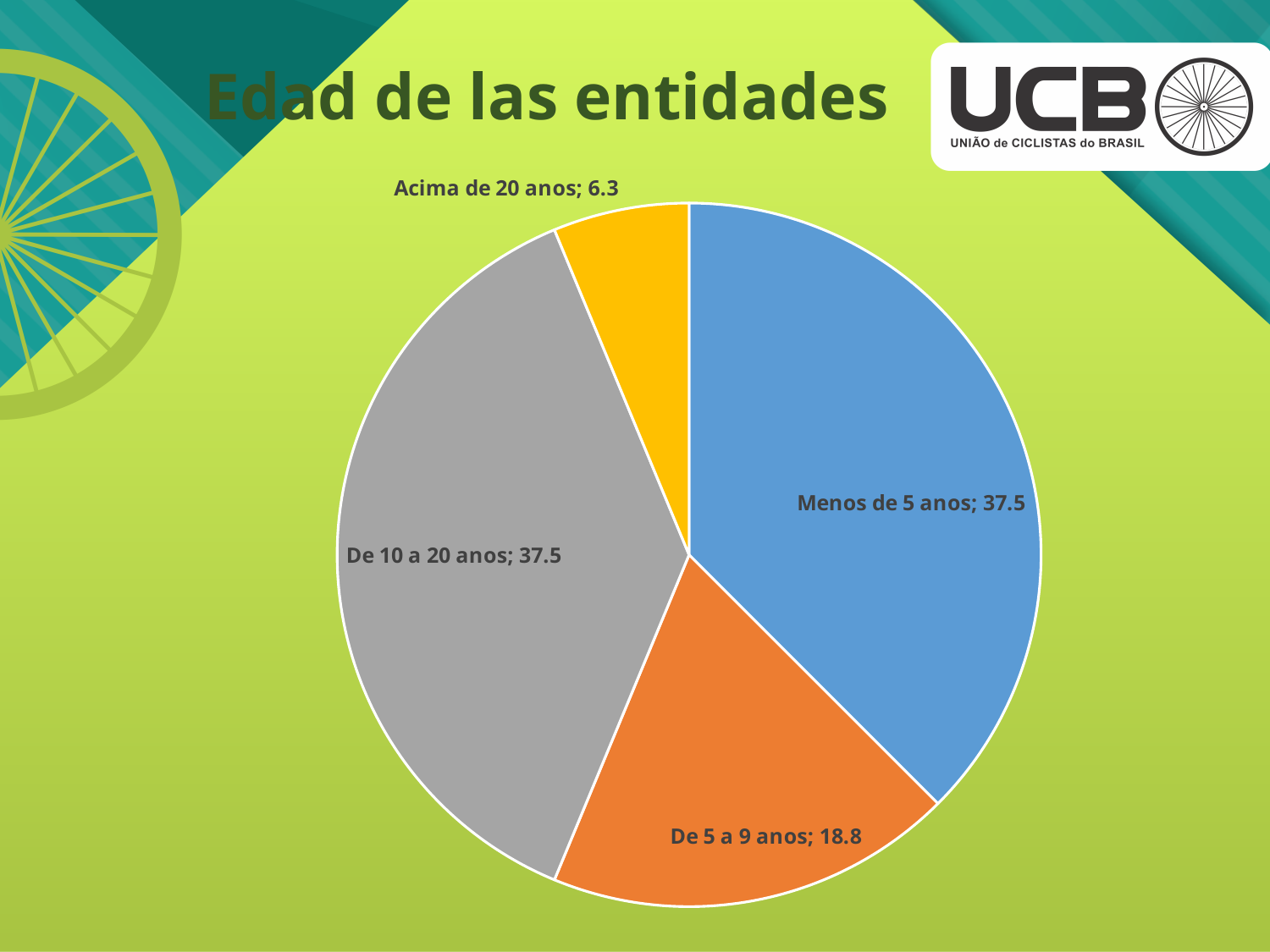
What kind of chart is shown on the slide? Pie chart How many slices does the pie chart have? 4 What is the title of the slide containing the chart? Edad de las entidades What value is shown for the "De 5 a 9 anos" slice? 18.8 What value is shown for the "De 10 a 20 anos" slice? 37.5 Which is larger, the value for "De 10 a 20 anos" or the value for "De 5 a 9 anos"? De 10 a 20 anos What value is shown for the "Menos de 5 anos" slice? 37.5 What is the difference between the values for "Menos de 5 anos" and "De 5 a 9 anos"? 18.7 What value is shown for the "Acima de 20 anos" slice? 6.3 What is the difference between the values for "De 5 a 9 anos" and "Acima de 20 anos"? 12.5 Which is larger, the value for "De 5 a 9 anos" or the value for "Acima de 20 anos"? De 5 a 9 anos Which category has the smallest slice of the pie? Acima de 20 anos